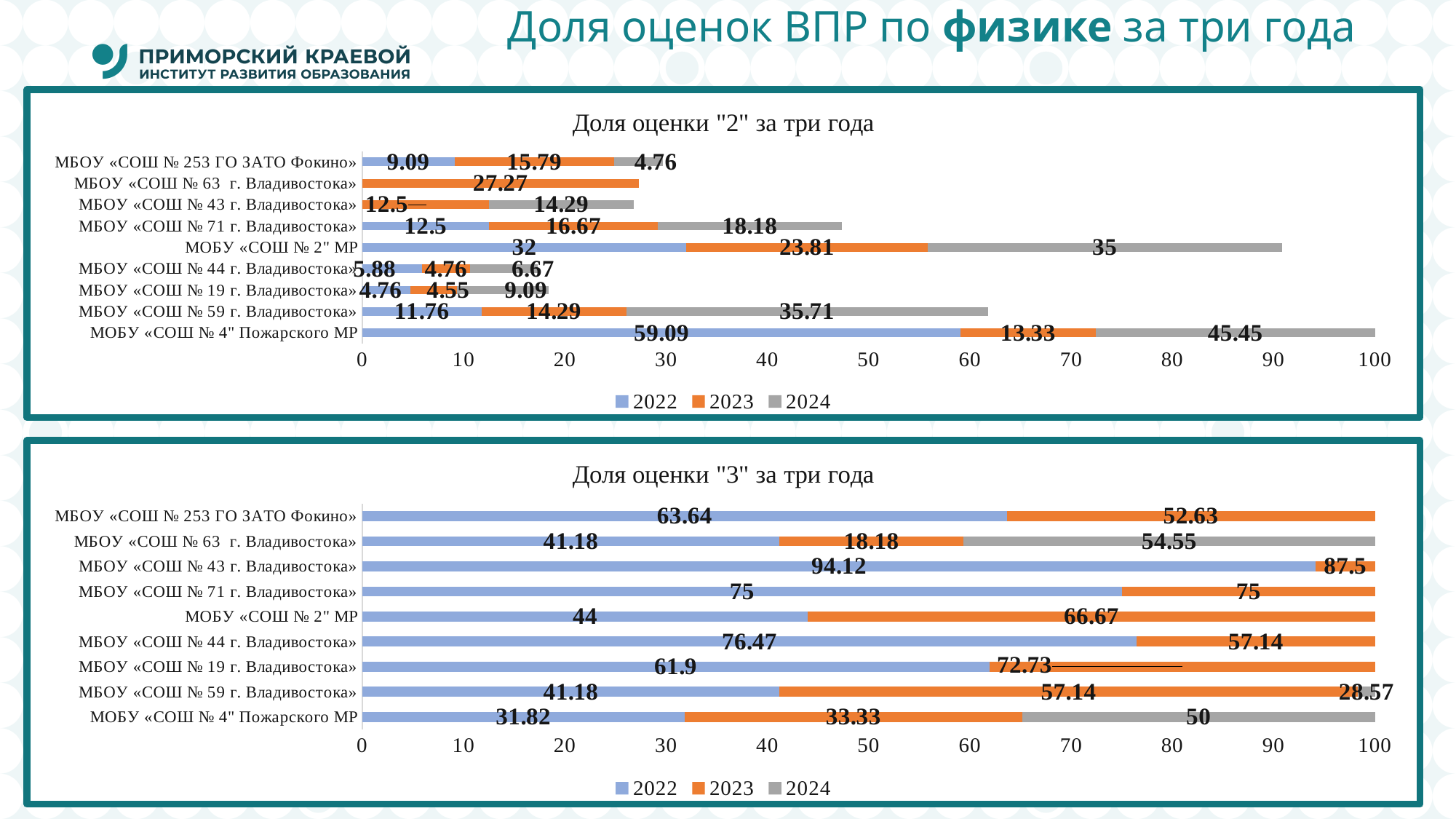
In the chart "Доля оценки "2" за три года", what is the total of the stacked bar for МБОУ «СОШ № 253 ГО ЗАТО Фокино»? 29.64 In the chart "Доля оценки "3" за три года", which is larger: the 2022 value for МБОУ «СОШ № 44 г. Владивостока» or the 2022 value for МБОУ «СОШ № 19 г. Владивостока»? МБОУ «СОШ № 44 г. Владивостока» How many series does the legend of the chart "Доля оценки "3" за три года" list? 3 In the chart "Доля оценки "2" за три года", what is the 2023 value for МБОУ «СОШ № 63 г. Владивостока»? 27.27 In the chart "Доля оценки "3" за три года", what is the 2024 value for МОБУ «СОШ № 4" Пожарского МР? 50 In the chart "Доля оценки "2" за три года", what is the difference between the 2024 and 2022 values for МОБУ «СОШ № 2" МР? 3 How many schools are listed on the vertical axis of the chart "Доля оценки "2" за три года"? 9 In the chart "Доля оценки "2" за три года", what is the 2024 value for МБОУ «СОШ № 59 г. Владивостока»? 35.71 In the chart "Доля оценки "3" за три года", which school has the highest 2022 value? МБОУ «СОШ № 43 г. Владивостока» In the chart "Доля оценки "2" за три года", which school has the highest 2022 value? МОБУ «СОШ № 4" Пожарского МР In the chart "Доля оценки "3" за три года", what is the 2022 value for МБОУ «СОШ № 43 г. Владивостока»? 94.12